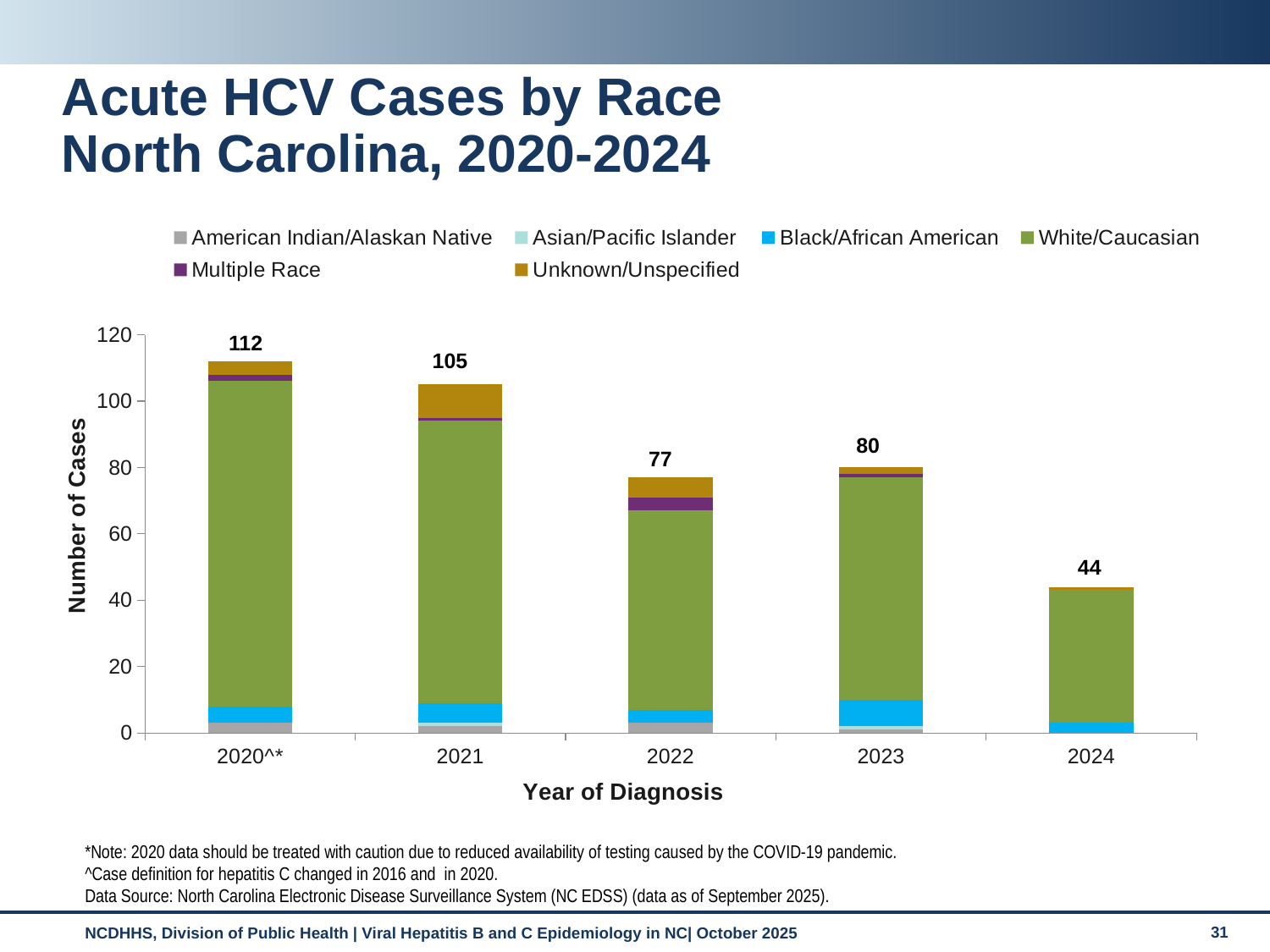
Do the total cases generally rise or fall from 2020^* to 2024? Fall How many years of diagnosis are shown on the x axis? 5 Is the total number of cases for 2022 greater or less than 80? less What is the label of the y axis? Number of Cases What kind of chart is shown on the slide? Stacked bar chart What is the total number of acute HCV cases shown for 2021? 105 Which year of diagnosis has the lowest total number of cases? 2024 Which year has more total cases, 2022 or 2023? 2023 What is the total number of acute HCV cases shown for 2024? 44 What is the difference between the total cases in 2020^* and 2024? 68 Which year of diagnosis has the highest total number of cases? 2020^* How many race categories does the legend list? 6